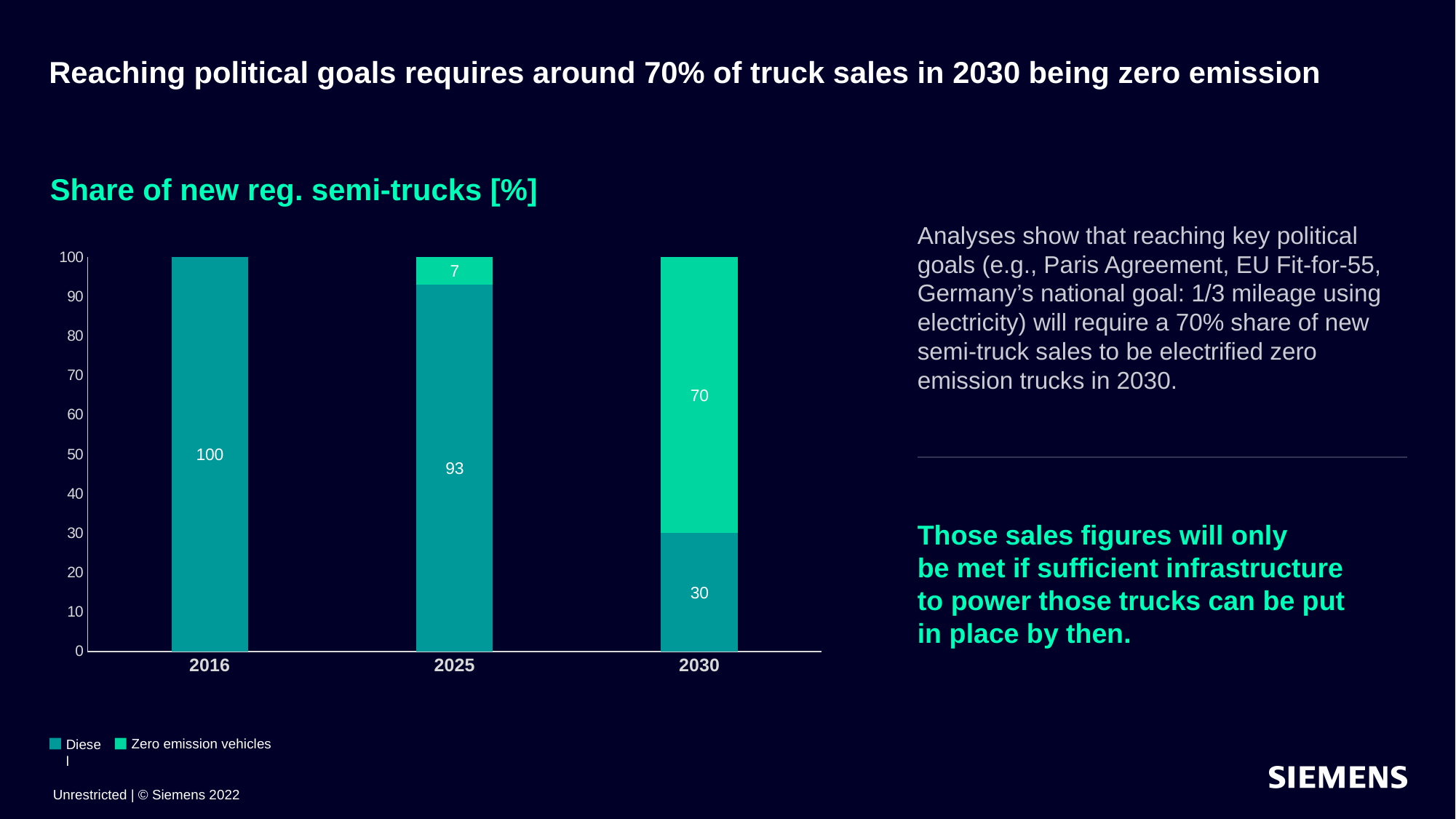
Which year has the lowest Diesel value? 2030 What is the Zero emission vehicles value for 2030? 70 How many years are shown on the x axis? 3 How many series does the legend list? 2 Which is larger in 2030, the Diesel value or the Zero emission vehicles value? Zero emission vehicles Which year has the highest Diesel value? 2016 What is the difference between the Diesel values for 2025 and 2030? 63 What is the total of the stacked bar for 2030? 100 What is the Diesel value for 2030? 30 What is the Diesel value for 2016? 100 What kind of chart is shown? Stacked bar chart What is the Zero emission vehicles value for 2025? 7